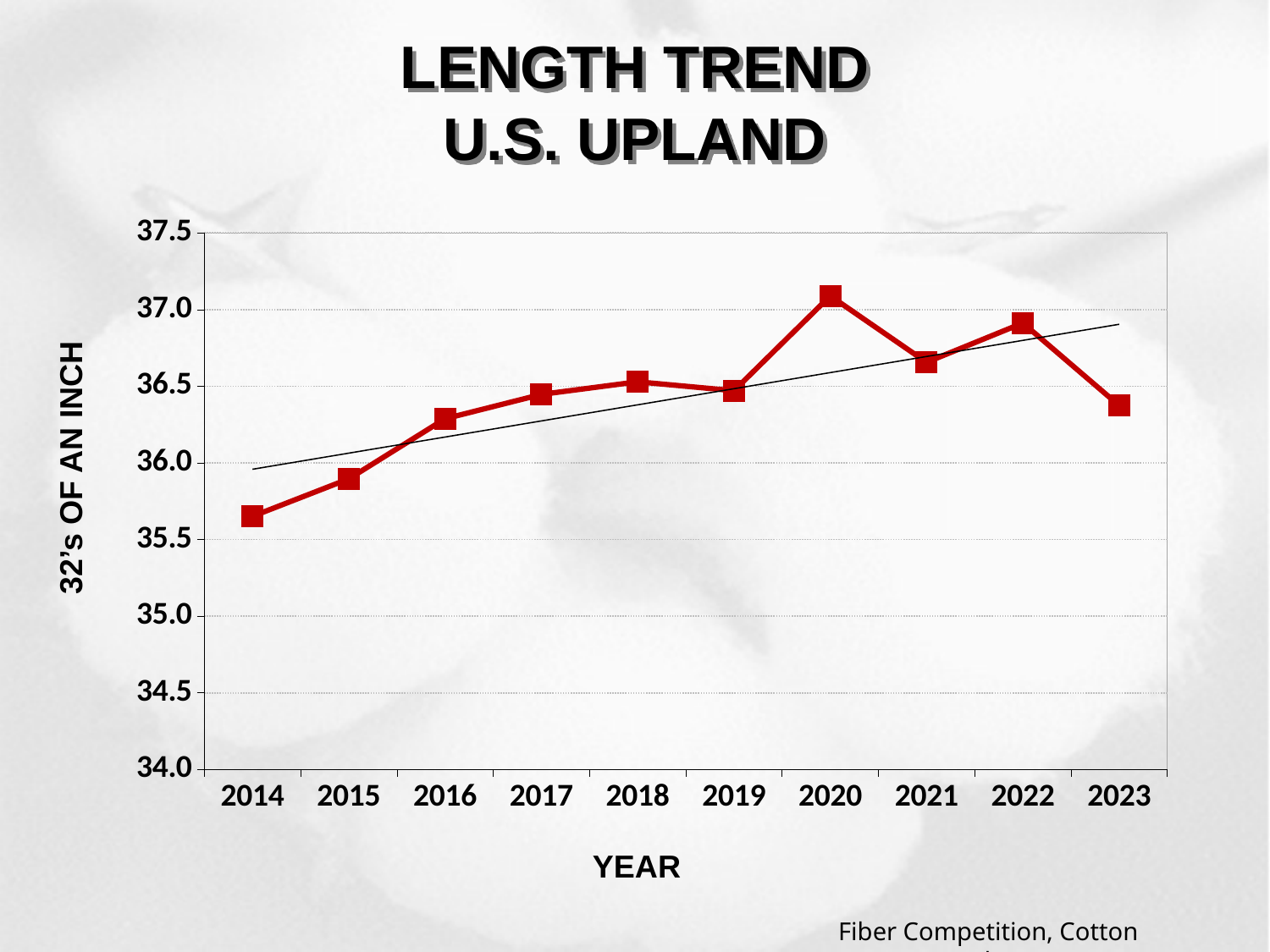
Overall, do the values rise or fall from 2014 to 2023? rise Is the value for 2021 greater or less than 36.5? greater Is the value for 2016 greater or less than 36.0? greater Is the value for 2014 greater or less than 36.0? less Which year has the larger value, 2014 or 2015? 2015 Which year has the larger value, 2020 or 2023? 2020 Which year has the lowest length value? 2014 Which year has the highest length value? 2020 What is the label on the vertical axis? 32's OF AN INCH What kind of chart is shown on the slide? line chart How many years are plotted on the x axis? 10